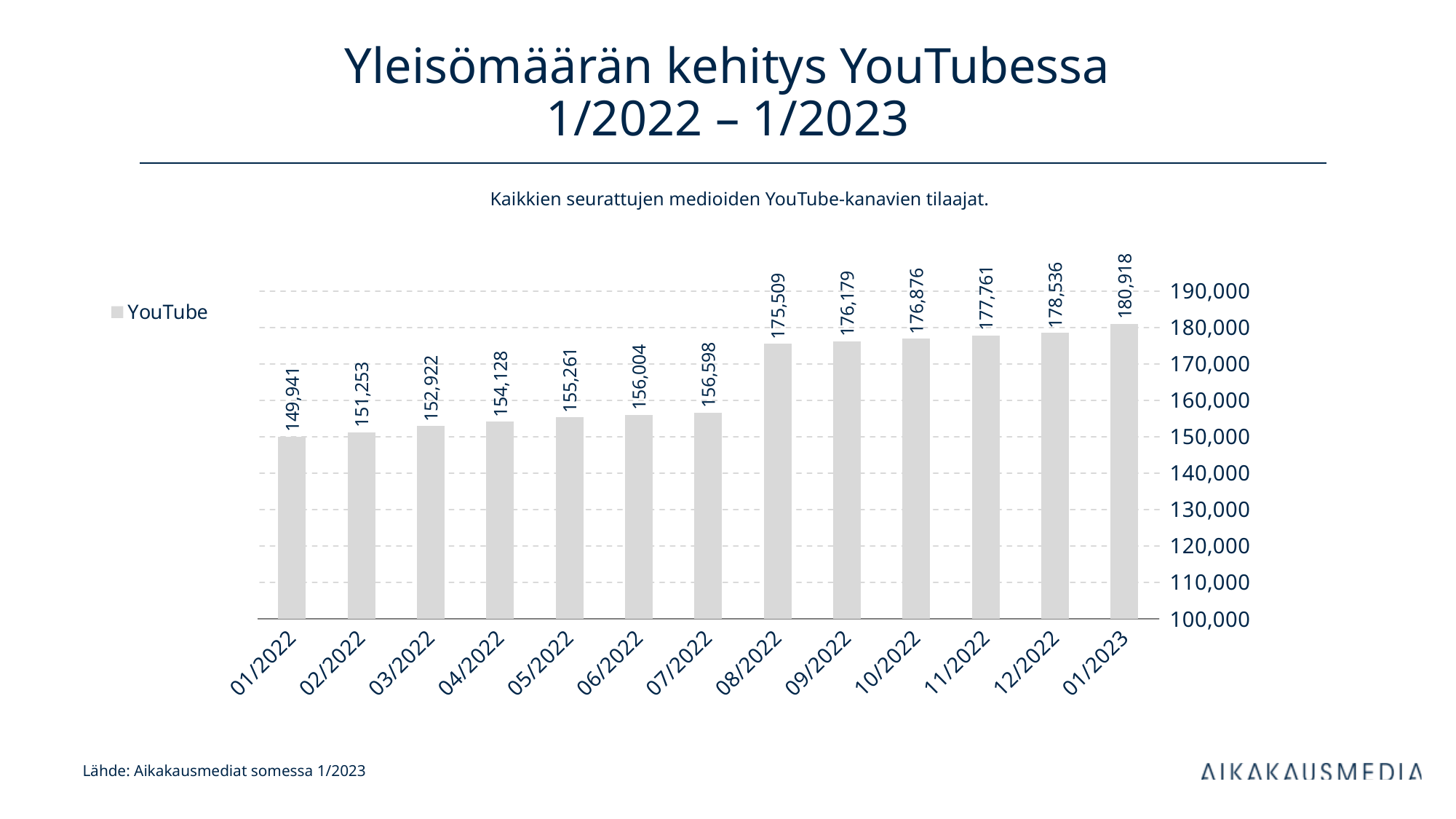
What is the value for 01/2022? 149,941 Which is larger, the value for 06/2022 or the value for 10/2022? 10/2022 What kind of chart is shown? bar chart What is the value for 01/2023? 180,918 Which month has the highest value? 01/2023 What is the difference between the values for 01/2023 and 01/2022? 30,977 Do the values rise or fall from 01/2022 to 01/2023? rise Which month has the lowest value? 01/2022 How many months are shown on the x axis? 13 Is the value for 05/2022 greater or less than 160,000? less What is the difference between the values for 08/2022 and 07/2022? 18,911 What is the value for 08/2022? 175,509